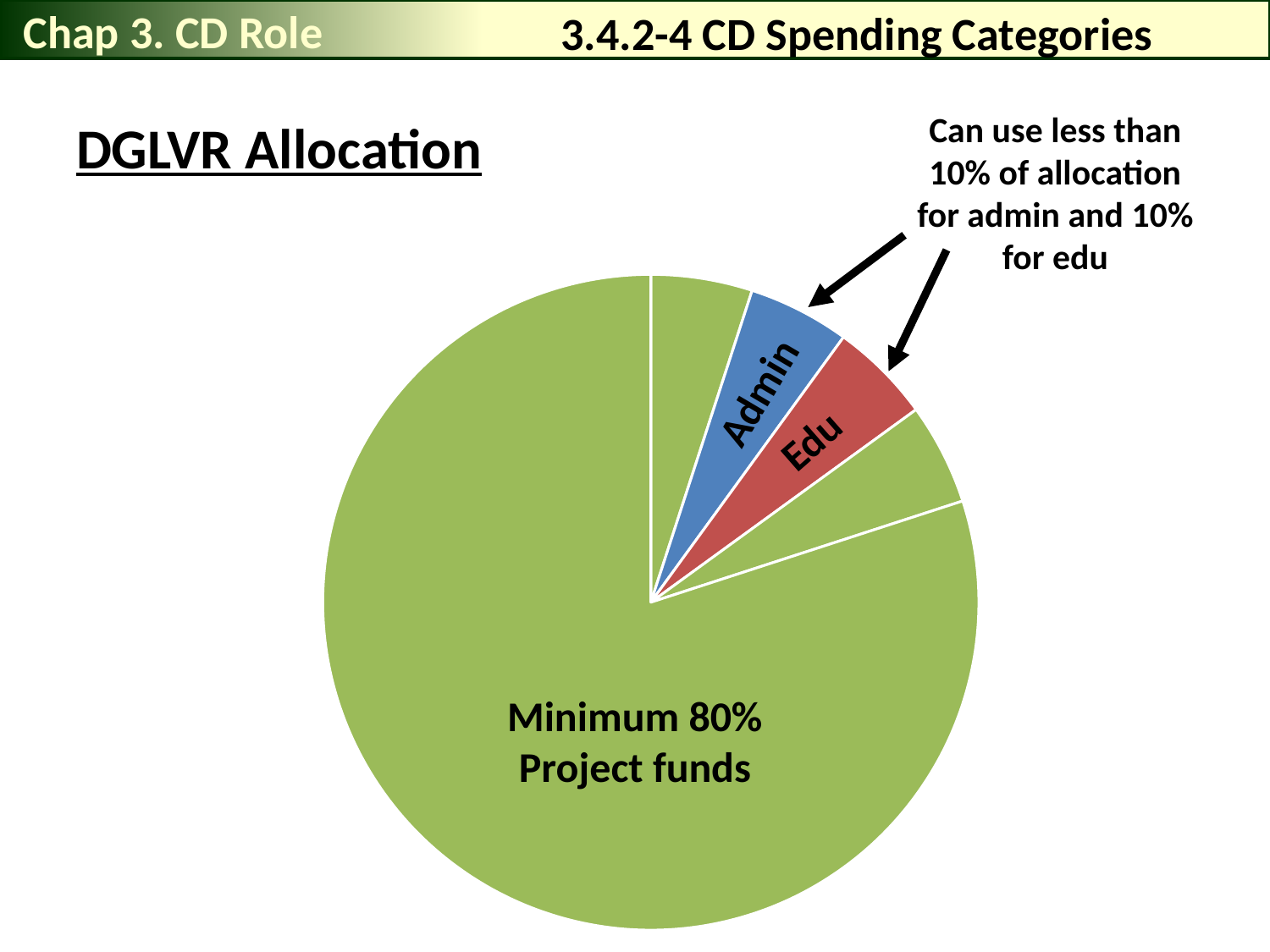
Which slice is larger, the Project funds slice or the Admin slice? Project funds What colour is the Admin slice of the pie chart? blue Which slice of the pie chart is the largest? Minimum 80% Project funds Which slice is larger, the Project funds slice or the Edu slice? Project funds What is the title of the pie chart? DGLVR Allocation What kind of chart is shown on the slide? pie chart